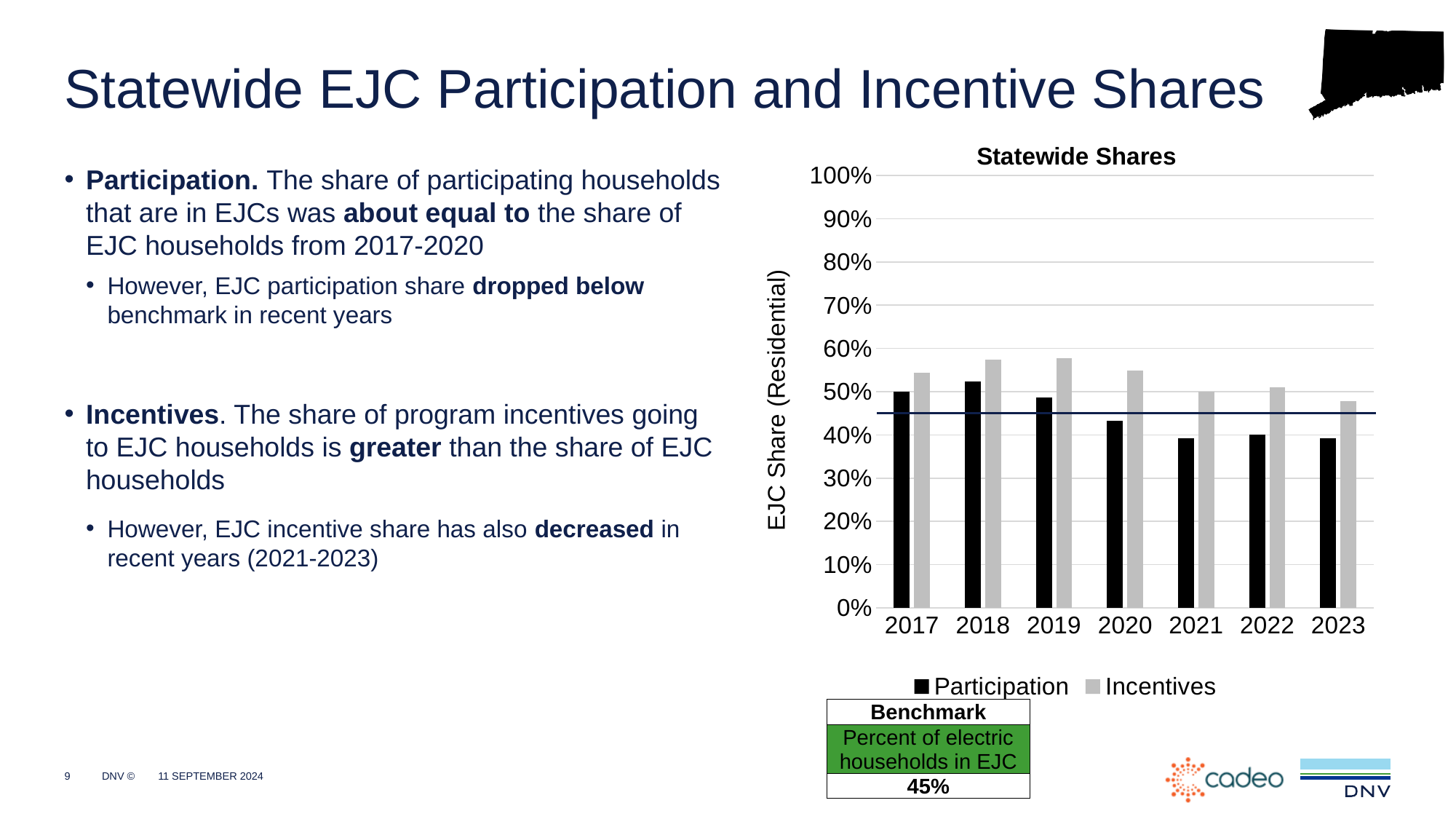
In the Statewide Shares chart, is the Incentives value for 2019 greater or less than 50%? greater In the Statewide Shares chart, is the Incentives value for 2018 greater or less than 50%? greater In the Statewide Shares chart, does the Participation share generally rise or fall from 2017 to 2023? fall In the Statewide Shares chart, which is larger for 2017: Participation or Incentives? Incentives How many series does the legend of the Statewide Shares chart list? 2 What is the y-axis label of the Statewide Shares chart? EJC Share (Residential) What kind of chart is the Statewide Shares chart? bar chart In the Statewide Shares chart, which year has the highest Participation share? 2018 How many years are shown on the x axis of the Statewide Shares chart? 7 What is the benchmark value shown below the Statewide Shares chart? 45% In the Statewide Shares chart, is the Participation value for 2020 greater or less than 50%? less